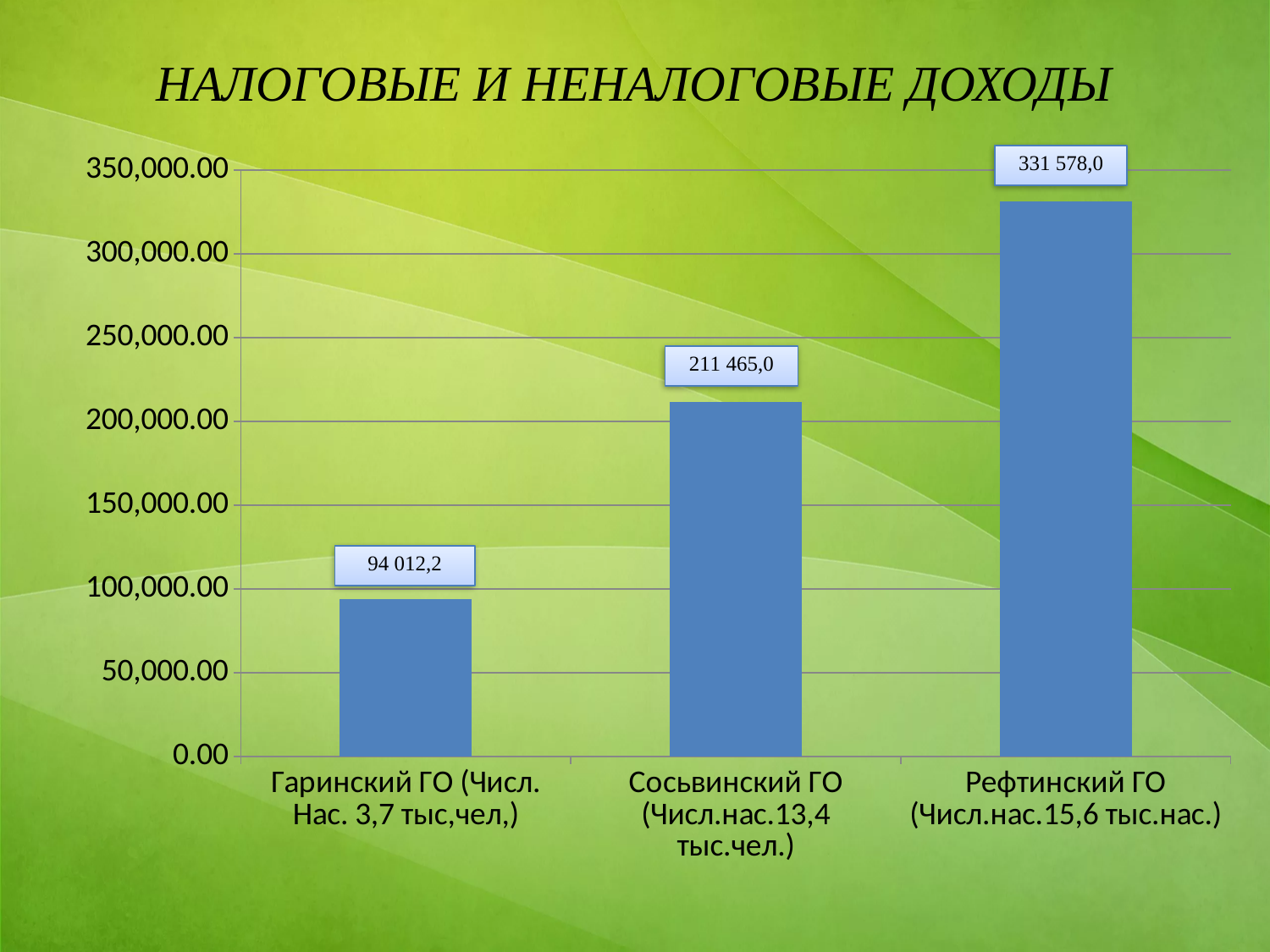
Which category has the lowest value? Гаринский ГО Is the value for Гаринский ГО greater or less than 100,000.00? less What is the value shown for Сосьвинский ГО? 211 465,0 Which is larger, the value for Сосьвинский ГО or the value for Гаринский ГО? Сосьвинский ГО What is the title of the slide? НАЛОГОВЫЕ И НЕНАЛОГОВЫЕ ДОХОДЫ Which category has the highest value? Рефтинский ГО What is the value shown for Гаринский ГО? 94 012,2 What is the value shown for Рефтинский ГО? 331 578,0 What kind of chart is shown on the slide? bar chart What is the difference between the values for Сосьвинский ГО and Гаринский ГО? 117 452,8 What is the difference between the values for Рефтинский ГО and Сосьвинский ГО? 120 113,0 How many categories are shown on the chart? 3